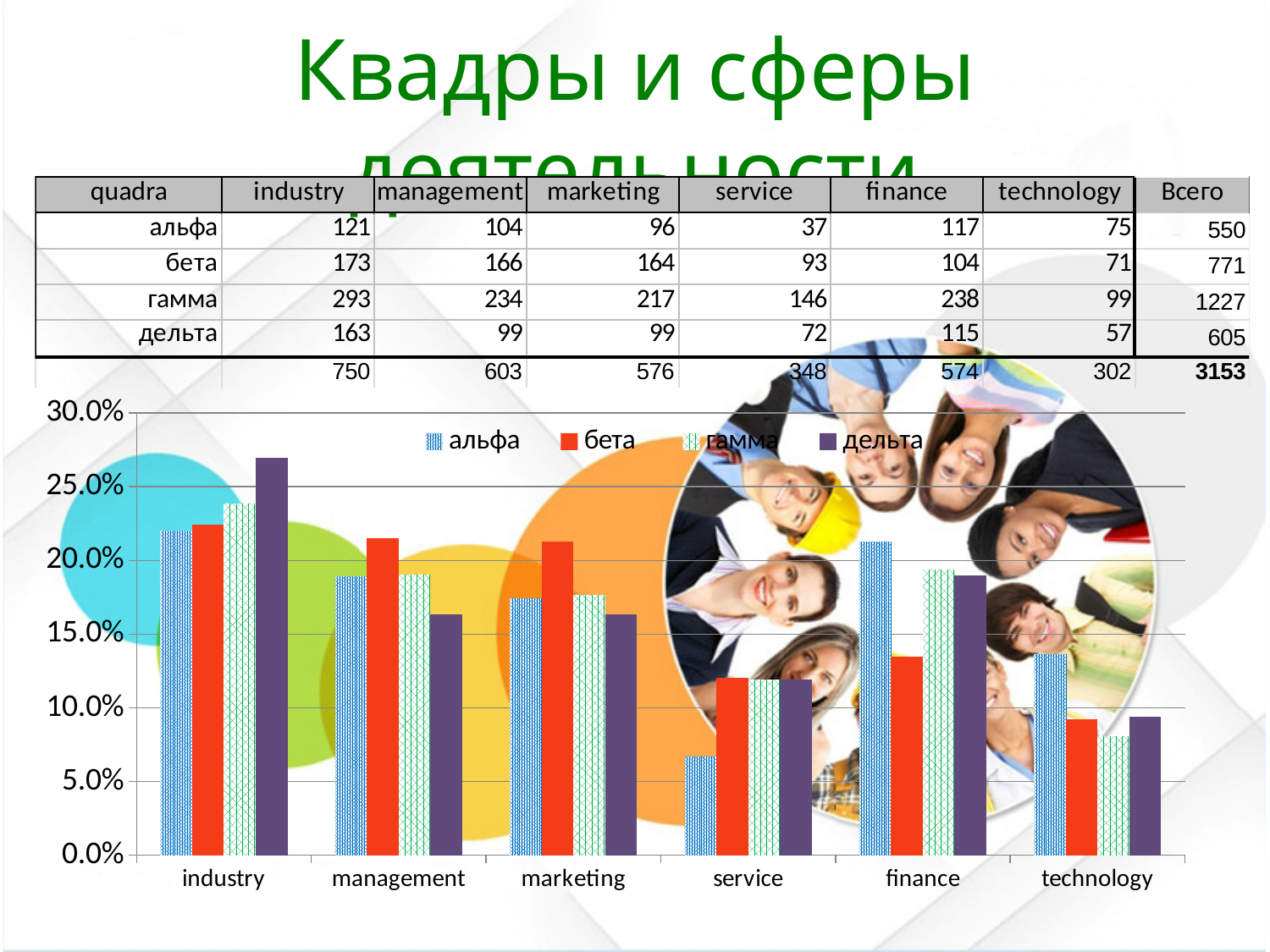
For the дельта series, which category has the highest bar? industry Which series are listed in the chart legend? альфа, бета, гамма, дельта How many categories are shown along the x axis of the chart? 6 For the альфа series, which category has the lowest bar? service For the бета series, which category has the lowest bar? technology What kind of chart is shown on the slide? bar chart For the гамма series, which category has the highest bar? industry Is the value for дельта in industry greater or less than 25.0%? greater In the finance category, which is larger: the альфа bar or the бета bar? альфа In the management category, which is larger: the бета bar or the дельта bar? бета How many series does the chart legend list? 4 Is the value for альфа in service greater or less than 10.0%? less